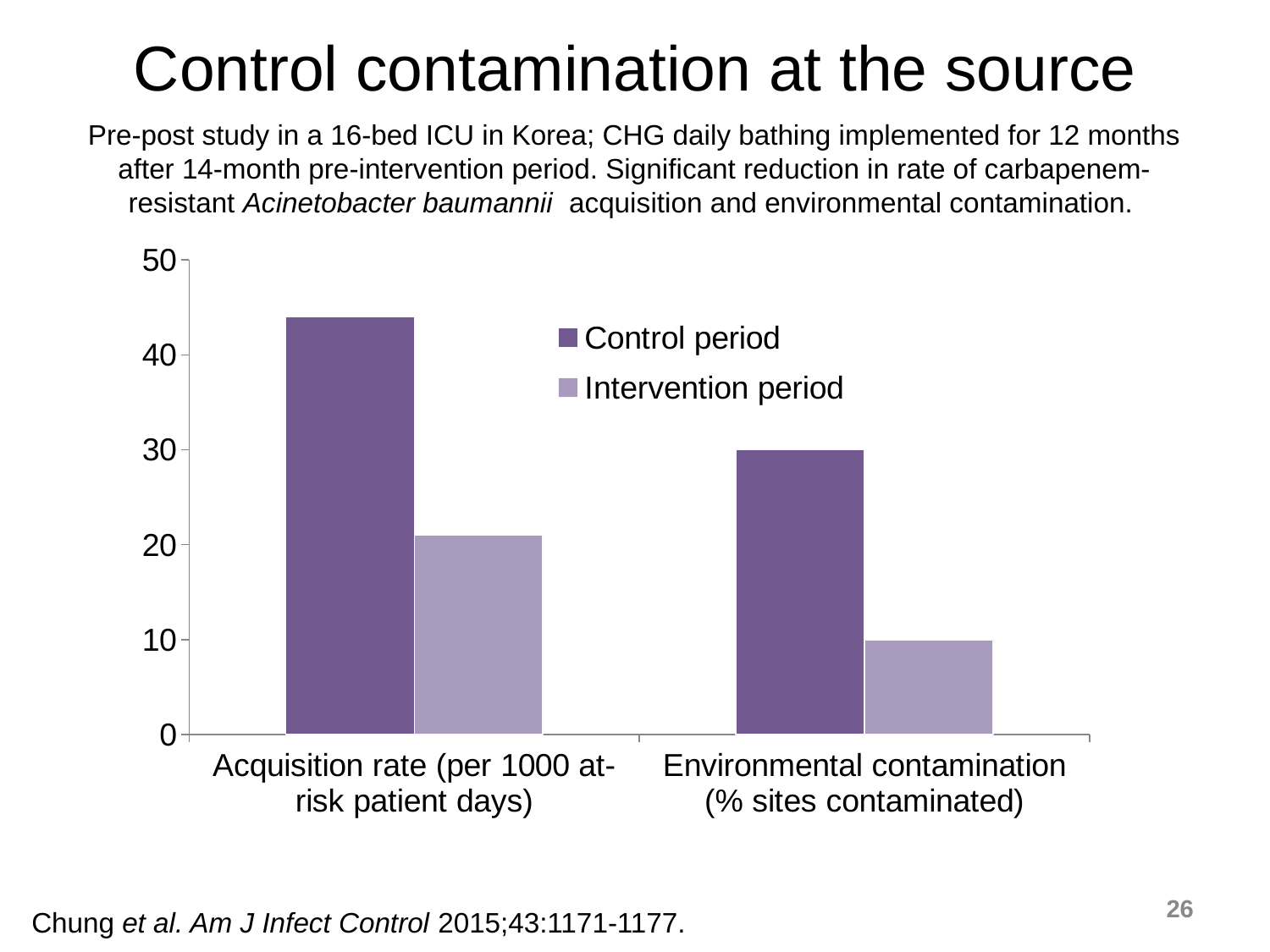
What are the two series named in the legend? Control period and Intervention period What is the Control period value for Environmental contamination (% sites contaminated)? 30 Which bar is the shortest in the chart? Intervention period, Environmental contamination (% sites contaminated) What is the difference between the Control period and Intervention period values for Environmental contamination (% sites contaminated)? 20 What kind of chart is shown on the slide? Bar chart Which bar is the tallest in the chart? Control period, Acquisition rate (per 1000 at-risk patient days) Is the Intervention period value for Acquisition rate (per 1000 at-risk patient days) greater or less than 30? less How many series does the legend list? 2 Is the Control period value for Acquisition rate (per 1000 at-risk patient days) greater or less than 40? greater How many categories are shown on the x axis? 2 What is the Intervention period value for Environmental contamination (% sites contaminated)? 10 Which series has the higher value for Acquisition rate (per 1000 at-risk patient days)? Control period